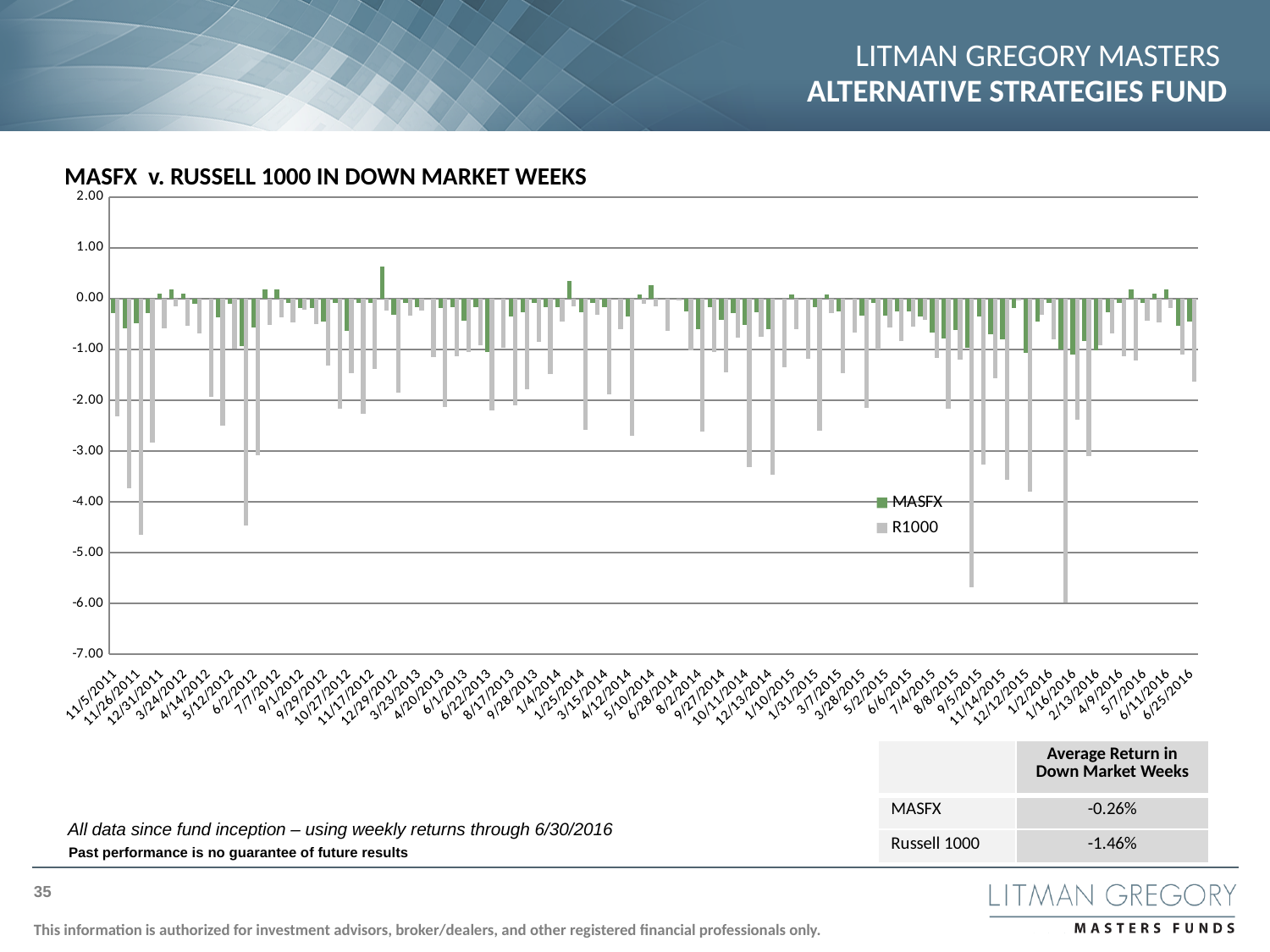
What is the lowest value shown on the chart's vertical axis? -7.00 What is the title of the chart? MASFX v. Russell 1000 in Down Market Weeks Is the lowest MASFX bar in the chart greater or less than -2.00? greater What is the highest value shown on the chart's vertical axis? 2.00 What is the first date label on the chart's horizontal axis? 11/5/2011 According to the table beside the chart, what is the average return in down market weeks for MASFX? -0.26% What is the last date label on the chart's horizontal axis? 6/25/2016 What kind of chart is shown on the slide? Bar chart How many series does the chart legend list? 2 Which series in the chart shows the deeper negative values overall, MASFX or R1000? R1000 Is the lowest R1000 bar in the chart greater or less than -5.00? less